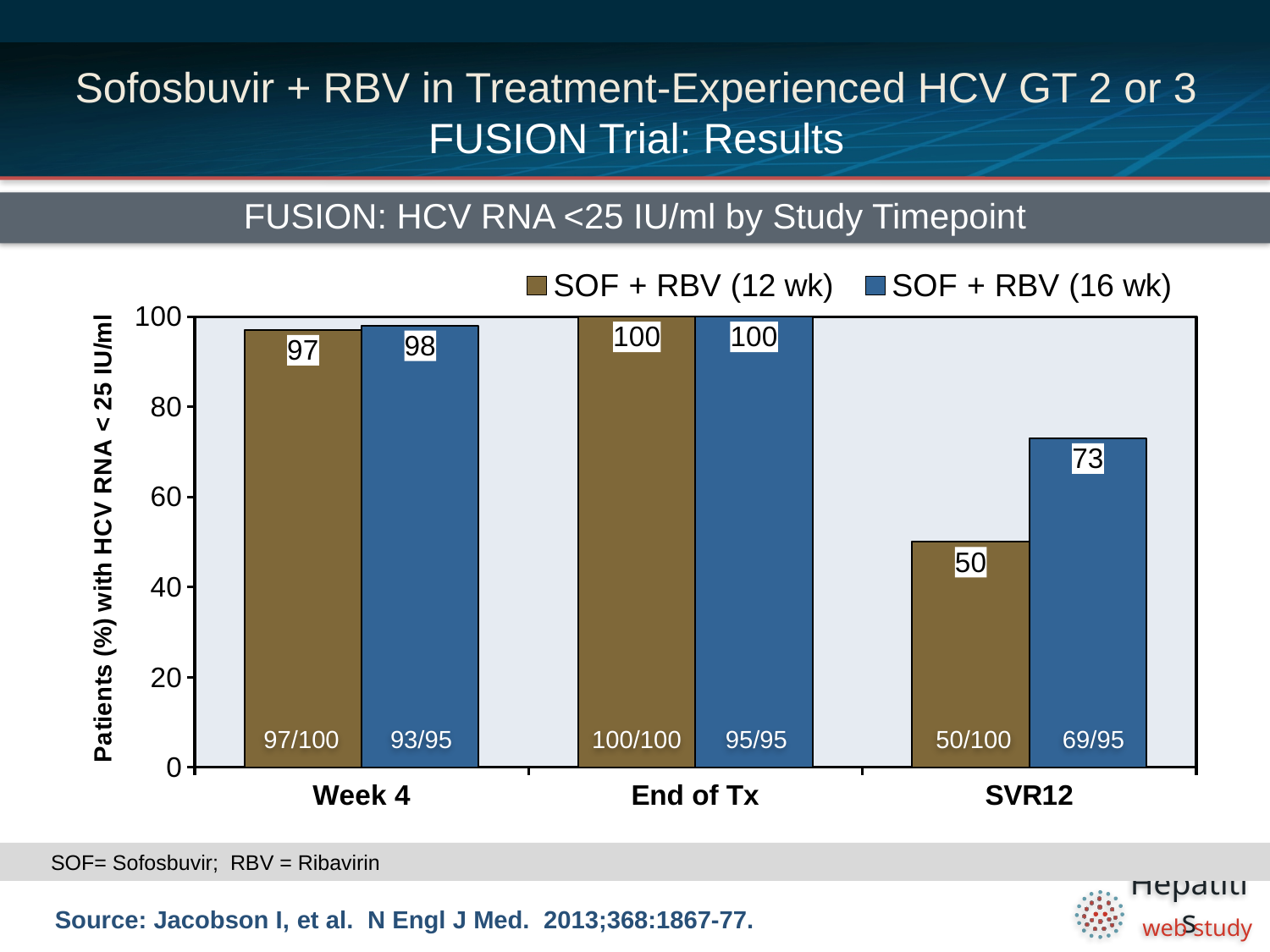
What is the value for SOF + RBV (16 wk) at SVR12? 73 What is the title of the chart? FUSION: HCV RNA <25 IU/ml by Study Timepoint How many series does the legend list? 2 How many timepoints are shown on the x axis? 3 At SVR12, which series has the larger value, SOF + RBV (12 wk) or SOF + RBV (16 wk)? SOF + RBV (16 wk) Which timepoint has the lowest value for SOF + RBV (12 wk)? SVR12 Is the value for SOF + RBV (16 wk) at SVR12 greater or less than 60? greater What kind of chart is shown on the slide? Bar chart What is the value for SOF + RBV (16 wk) at Week 4? 98 What is the value for SOF + RBV (12 wk) at End of Tx? 100 What is the difference between the SOF + RBV (16 wk) and SOF + RBV (12 wk) values at SVR12? 23 What is the value for SOF + RBV (12 wk) at Week 4? 97